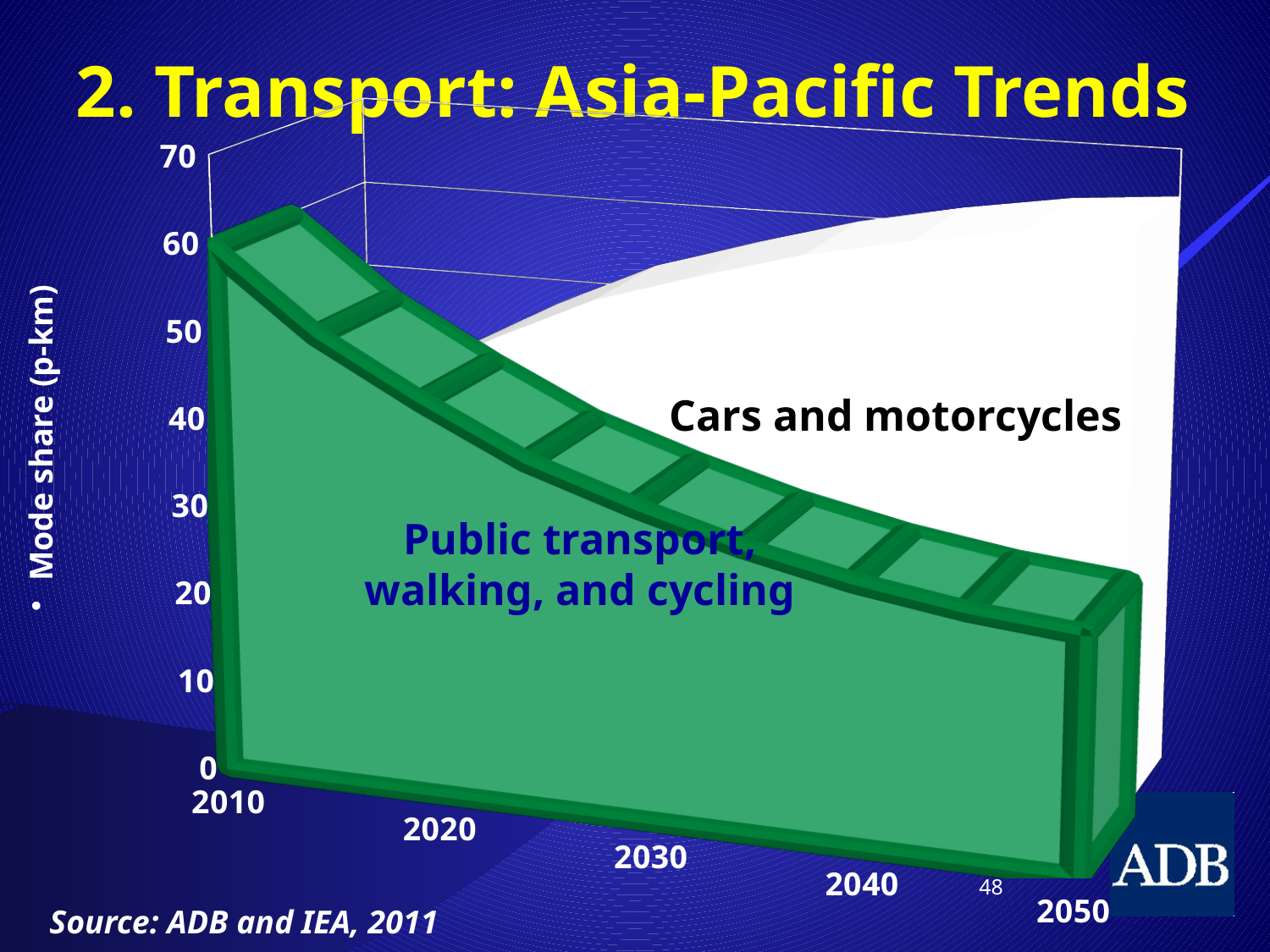
Is the 2010 mode share for public transport, walking, and cycling greater or less than 70? less In 2050, which has the larger mode share: public transport, walking, and cycling, or cars and motorcycles? Cars and motorcycles Is the 2010 mode share for public transport, walking, and cycling greater or less than 50? greater What is the label on the vertical axis of the chart? Mode share (p-km) How many year labels are shown on the x axis? 5 What colour is the area representing public transport, walking, and cycling? green In 2010, which has the larger mode share: public transport, walking, and cycling, or cars and motorcycles? Public transport, walking, and cycling How many series are plotted in the chart? 2 Does the mode share for cars and motorcycles rise or fall from 2010 to 2050? rise Does the mode share for public transport, walking, and cycling rise or fall from 2010 to 2050? fall What kind of chart is shown on the slide? area chart